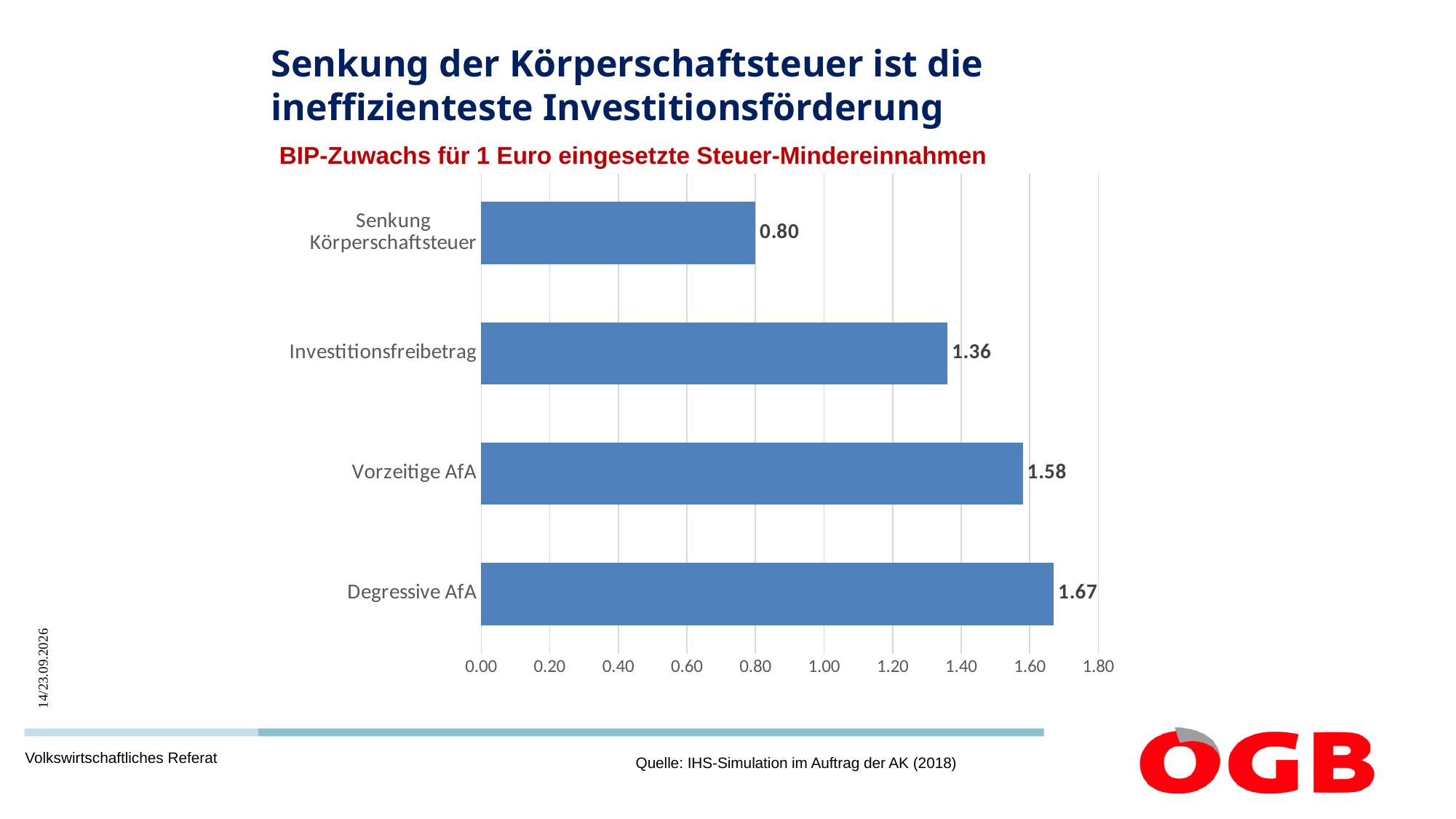
What kind of chart is shown on the slide? Bar chart Which category has the lowest value? Senkung Körperschaftsteuer What is the value for Degressive AfA? 1.67 Which is larger, the value for Investitionsfreibetrag or the value for Vorzeitige AfA? Vorzeitige AfA Which category has the highest value? Degressive AfA What is the title of the chart? BIP-Zuwachs für 1 Euro eingesetzte Steuer-Mindereinnahmen What is the value for Investitionsfreibetrag? 1.36 What is the difference between the values for Degressive AfA and Senkung Körperschaftsteuer? 0.87 What is the value for Senkung Körperschaftsteuer? 0.80 What is the value for Vorzeitige AfA? 1.58 How many categories are shown in the chart? 4 What is the difference between the values for Vorzeitige AfA and Investitionsfreibetrag? 0.22